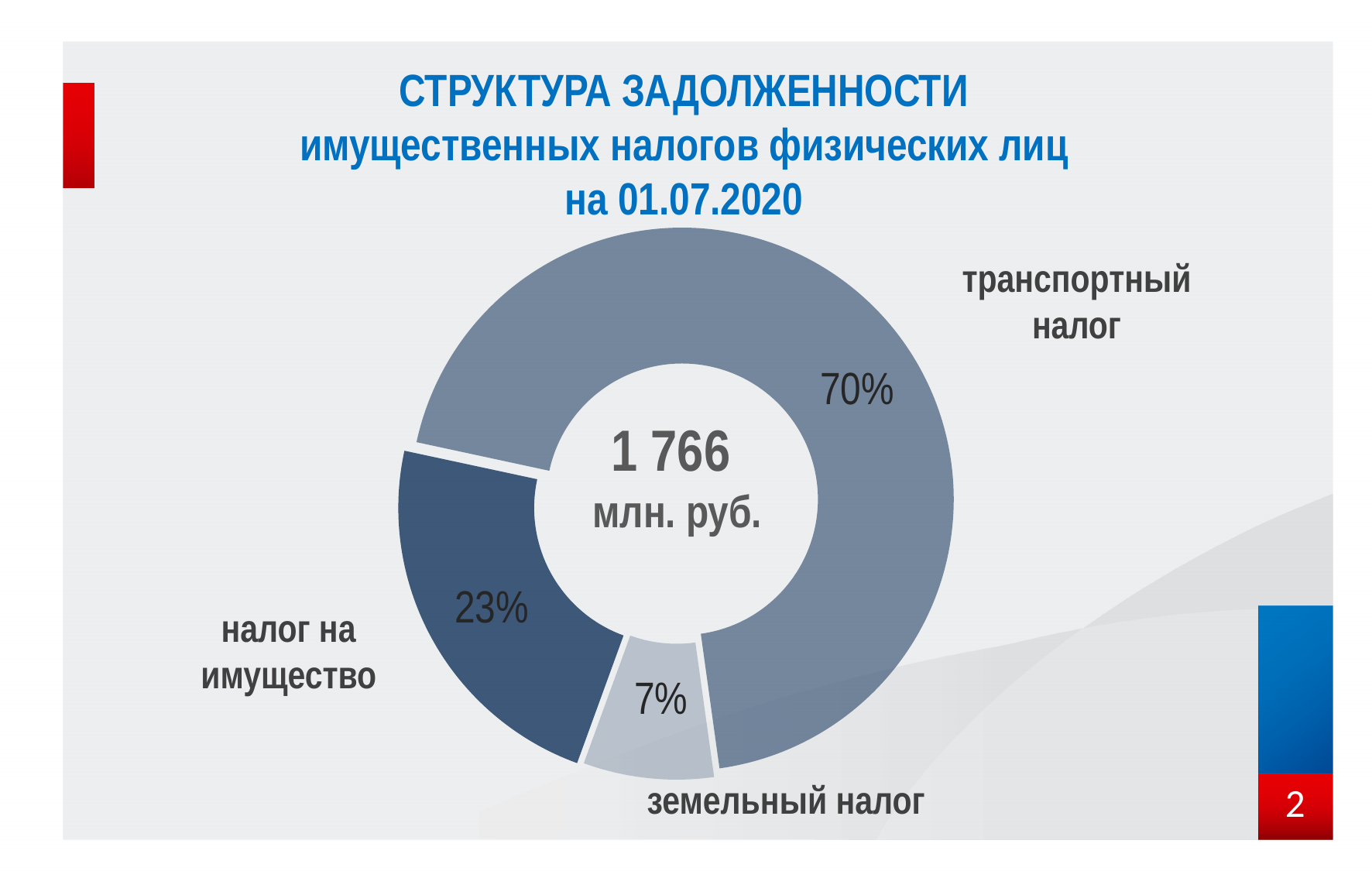
What is the difference in percentage points between транспортный налог and налог на имущество? 47 As of what date is the debt structure shown? 01.07.2020 What total value is shown in the centre of the chart? 1 766 млн. руб. Which category has the largest share of the debt? транспортный налог How many categories does the chart show? 3 Which category has the smallest share of the debt? земельный налог What is the difference in percentage points between налог на имущество and земельный налог? 16 What share of the debt is земельный налог? 7% What kind of chart is shown on the slide? pie chart (doughnut) What share of the debt is налог на имущество? 23% What share of the debt is транспортный налог? 70% Which is larger: the share of налог на имущество or the share of земельный налог? налог на имущество